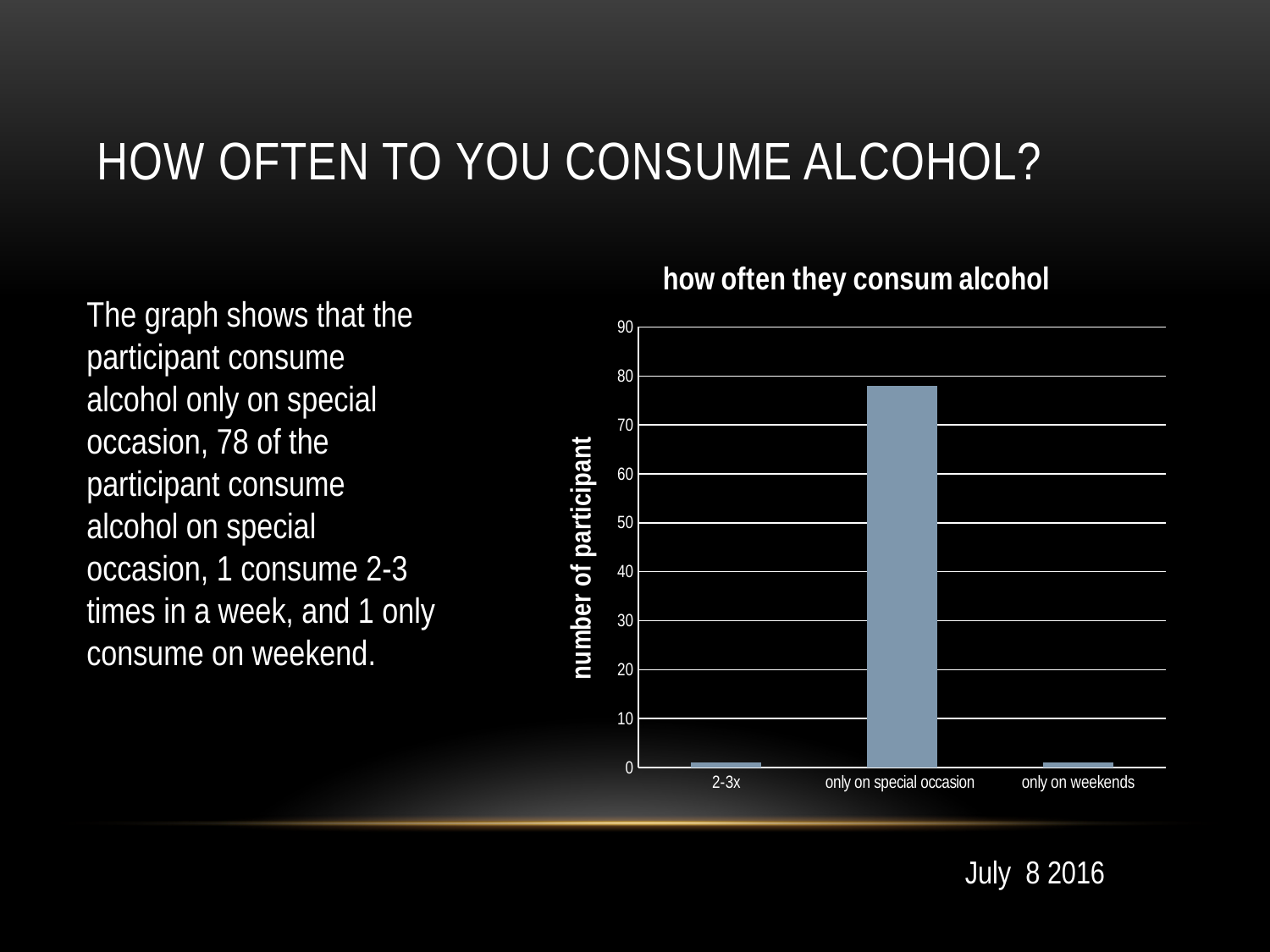
What kind of chart is shown on the slide? bar chart Which is larger, the value for 'only on special occasion' or the value for '2-3x'? only on special occasion Which category has the highest number of participants? only on special occasion Is the value for '2-3x' greater or less than 10? less Which is larger, the value for 'only on weekends' or the value for 'only on special occasion'? only on special occasion What is the highest value shown on the vertical axis of the chart? 90 How many categories are shown on the x axis of the chart? 3 What is the label on the vertical axis of the chart? number of participant Is the value for 'only on special occasion' greater or less than 80? less Is the value for 'only on special occasion' greater or less than 70? greater What is the title of the chart? how often they consum alcohol